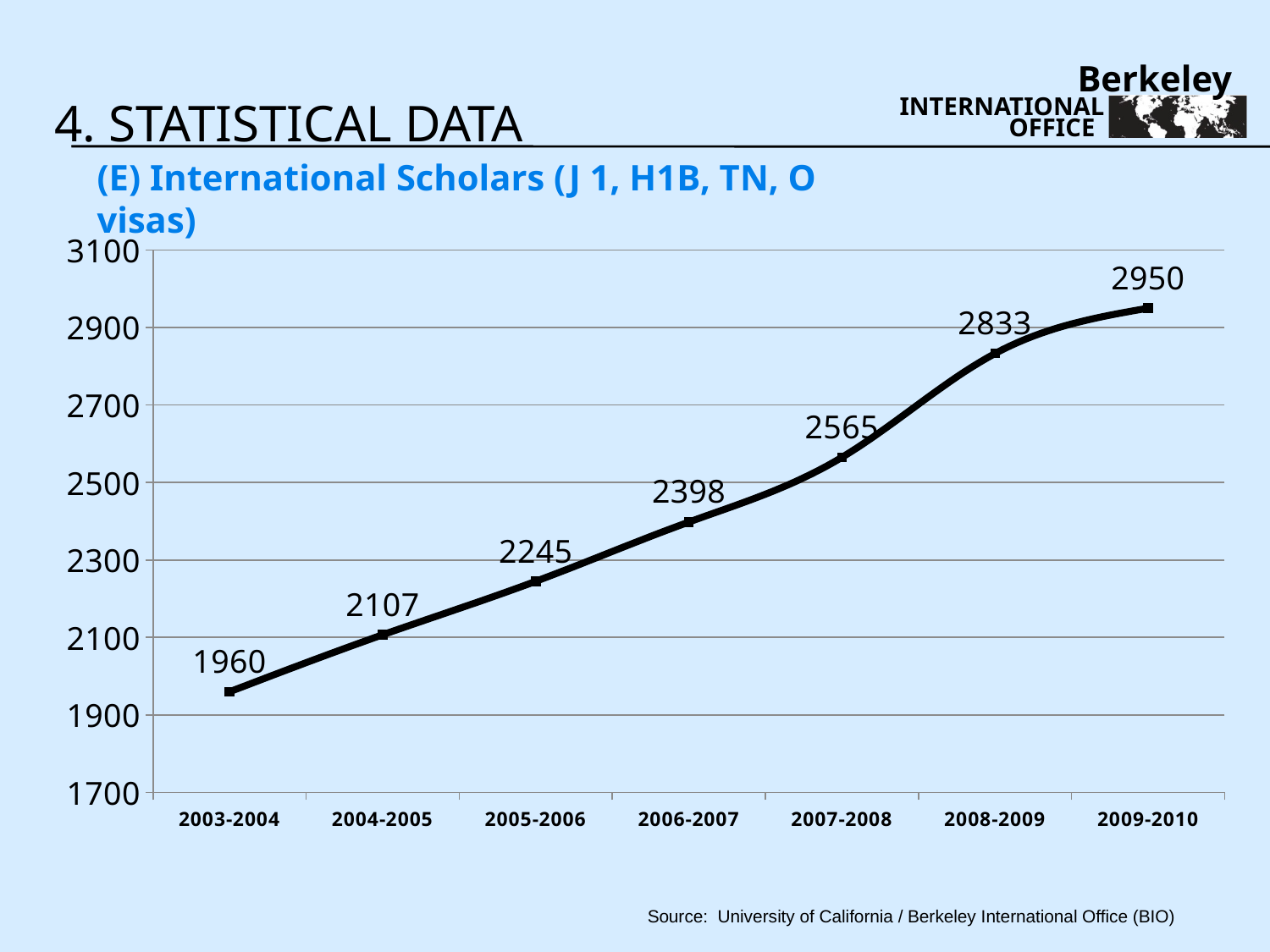
What is the difference in international scholars between 2008-2009 and 2007-2008? 268 What is the number of international scholars in 2009-2010? 2950 What kind of chart is shown on the slide? line chart What is the number of international scholars in 2006-2007? 2398 What is the difference in international scholars between 2009-2010 and 2003-2004? 990 Which academic year has the lowest number of international scholars? 2003-2004 Which academic year has the highest number of international scholars? 2009-2010 Which year has more international scholars, 2005-2006 or 2007-2008? 2007-2008 Is the value for 2004-2005 greater or less than 2100? greater How many academic years are plotted on the chart? 7 What is the number of international scholars in 2003-2004? 1960 Do the values rise or fall from 2003-2004 to 2009-2010? rise